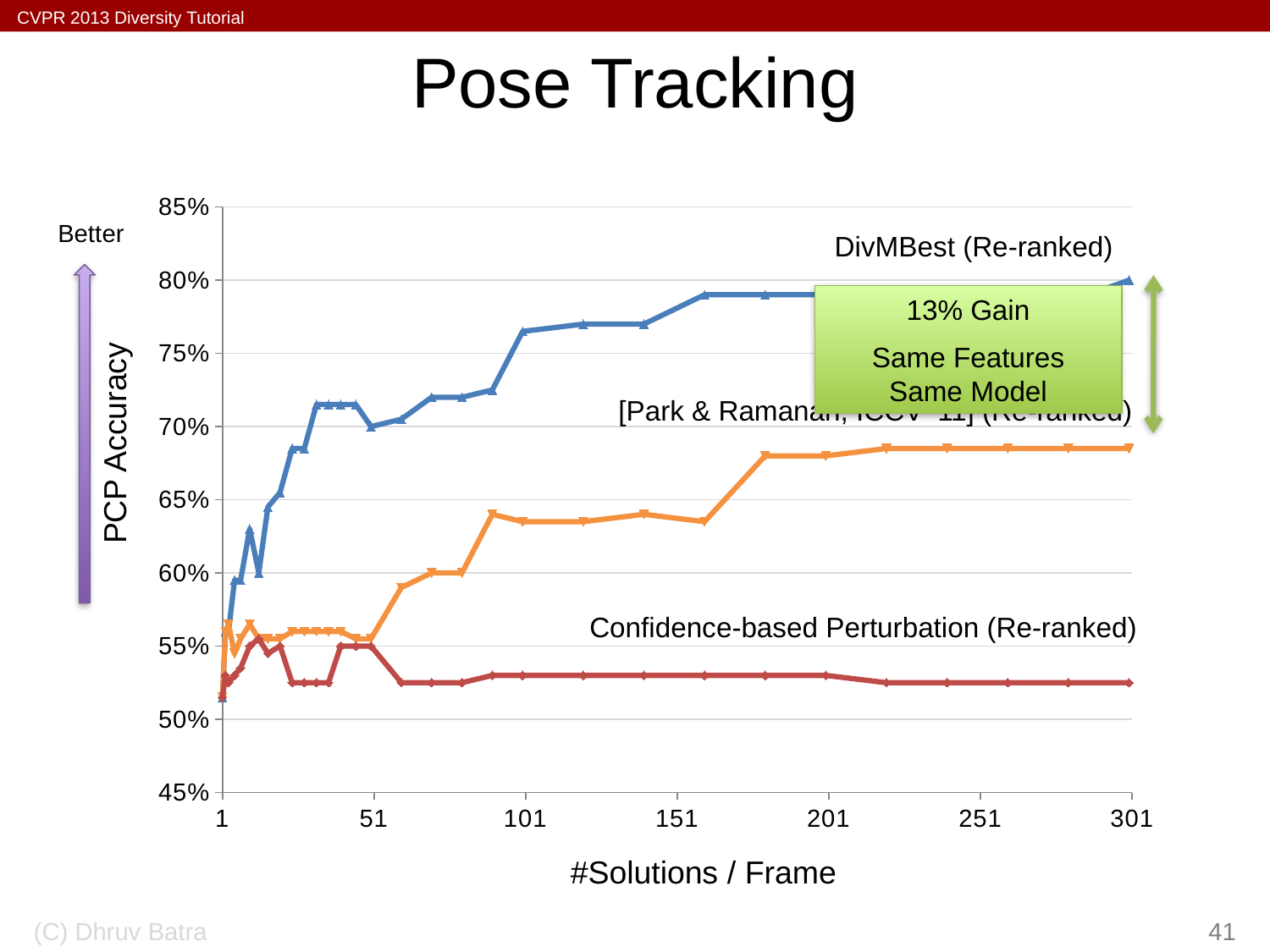
What kind of chart is shown on the slide? line chart What is the label of the y axis? PCP Accuracy Which series has the highest PCP Accuracy at 301 solutions per frame? DivMBest (Re-ranked) At 101 solutions per frame, which is higher: [Park & Ramanan, ICCV '11] (Re-ranked) or Confidence-based Perturbation (Re-ranked)? [Park & Ramanan, ICCV '11] (Re-ranked) How many series are plotted on the chart? 3 What is the label of the x axis? #Solutions / Frame Which series has the lowest PCP Accuracy at 301 solutions per frame? Confidence-based Perturbation (Re-ranked) Does the DivMBest (Re-ranked) series rise or fall as #Solutions / Frame increases? rise Is the value for DivMBest (Re-ranked) at 301 solutions per frame greater or less than 75%? greater Is the value for Confidence-based Perturbation (Re-ranked) at 251 solutions per frame greater or less than 55%? less At 301 solutions per frame, which is higher: DivMBest (Re-ranked) or [Park & Ramanan, ICCV '11] (Re-ranked)? DivMBest (Re-ranked) Is the value for [Park & Ramanan, ICCV '11] (Re-ranked) at 301 solutions per frame greater or less than 65%? greater